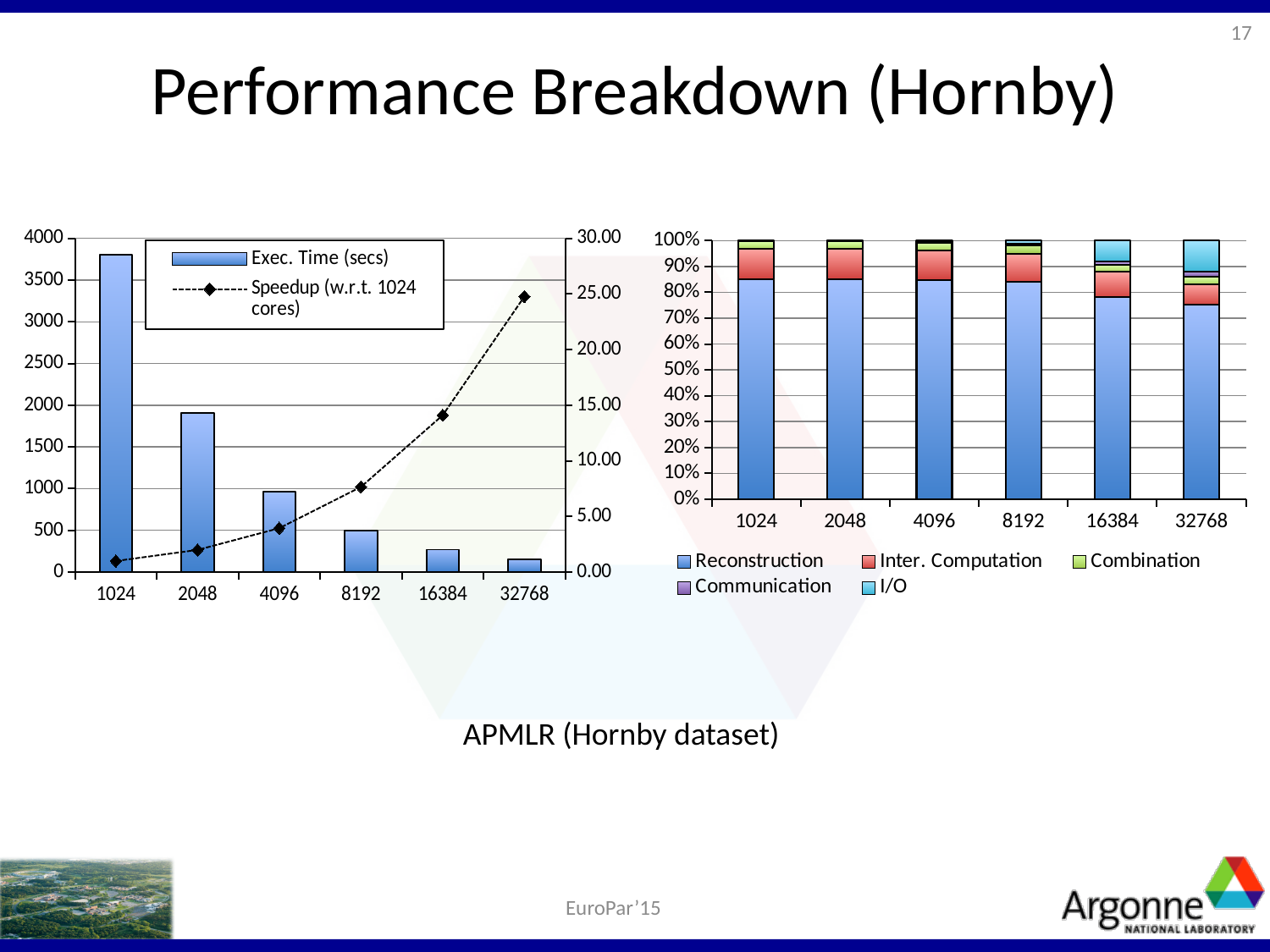
How many core counts are shown on the x axis of the right chart? 6 On the left chart, is the execution time for 1024 cores greater or less than 3500? greater On the left chart, is the speedup for 32768 cores greater or less than 20.00? greater On the left chart, does the speedup rise or fall as the number of cores increases? rise On the left chart, what kind of chart is used for the Exec. Time (secs) series? bar chart On the left chart, which core count has the highest execution time? 1024 On the right chart, is the Reconstruction share for 32768 cores greater or less than 70%? greater How many series does the legend of the right chart list? 5 On the left chart, which core count has the lowest execution time? 32768 On the left chart, does the execution time rise or fall as the number of cores increases? fall On the left chart, which has a larger execution time, 2048 cores or 8192 cores? 2048